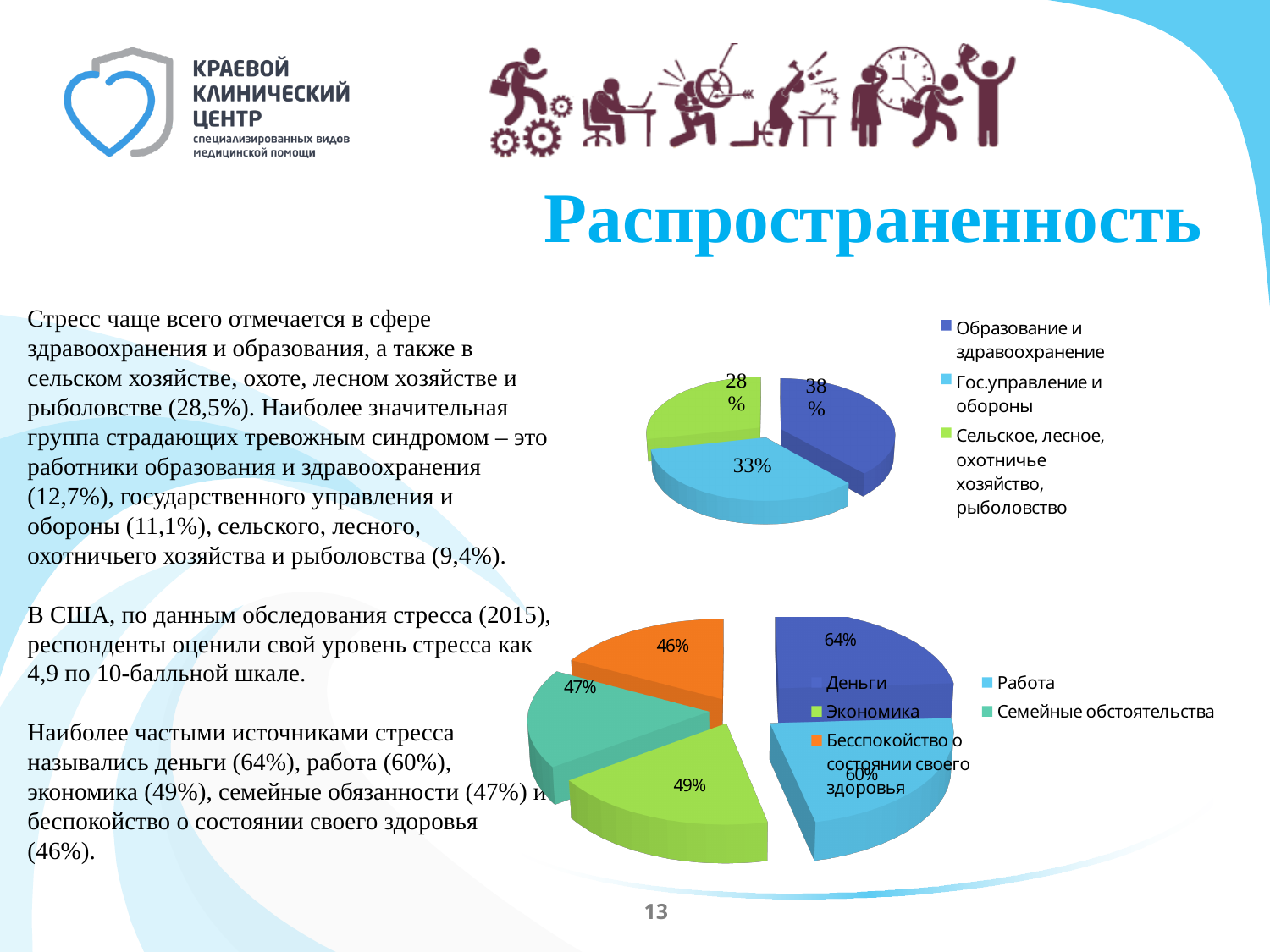
In the upper pie chart, which category has the smallest slice? Сельское, лесное, охотничье хозяйство, рыболовство In the upper pie chart, what is the value for Образование и здравоохранение? 38% In the lower pie chart, what colour is the slice for Беспокойство о состоянии своего здоровья? orange In the lower pie chart, which is larger: Работа or Семейные обстоятельства? Работа In the lower pie chart, what is the value for Экономика? 49% What type of chart is the upper chart on the slide? pie chart How many categories does the legend of the lower pie chart list? 5 In the lower pie chart, which category has the largest value? Деньги How many categories does the upper pie chart show? 3 In the lower pie chart, what is the value for Деньги? 64% In the upper pie chart, what is the value for Гос.управление и обороны? 33% In the upper pie chart, what is the difference between Образование и здравоохранение and Гос.управление и обороны? 5%